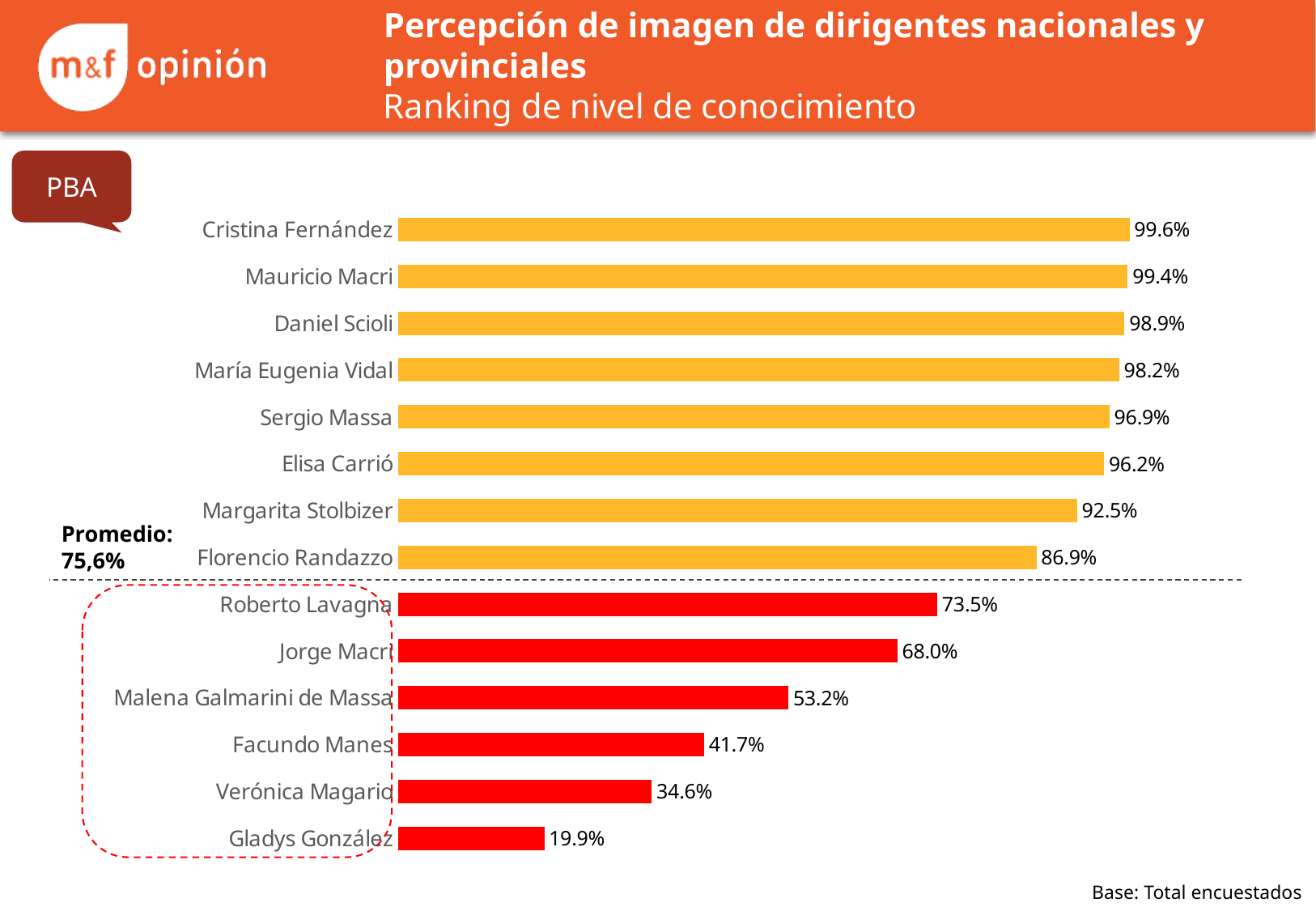
How many people are shown on the chart? 14 What is the difference between the values for Roberto Lavagna and Jorge Macri? 5.5% What is the value for Margarita Stolbizer? 92.5% What kind of chart is shown on the slide? Bar chart What is the value for Facundo Manes? 41.7% What average (Promedio) value is shown on the slide? 75,6% What is the value for Daniel Scioli? 98.9% Which person has the lowest value on the chart? Gladys González How many bars are coloured red on the chart? 6 What is the difference between the values for Sergio Massa and Florencio Randazzo? 10.0% Which person has the highest value on the chart? Cristina Fernández Which is larger, the value for Malena Galmarini de Massa or the value for Verónica Magario? Malena Galmarini de Massa